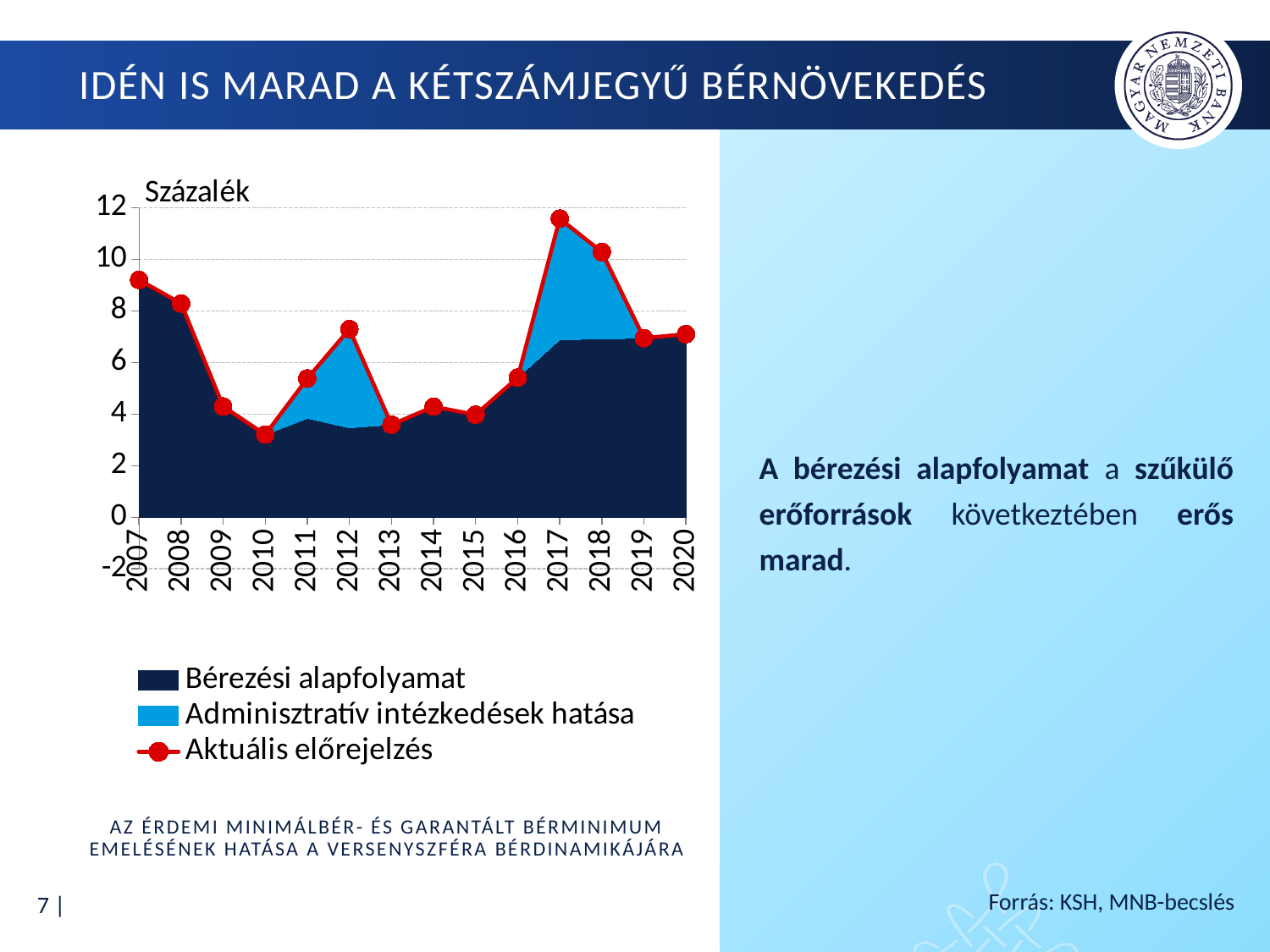
Is the value of the Aktuális előrejelzés line for 2017 greater or less than 10? greater Is the value of the Aktuális előrejelzés line for 2010 greater or less than 4? less How many years are shown on the x axis of the chart? 14 What kind of chart is shown on the slide? Stacked area chart with a line series In which year does the Aktuális előrejelzés line reach its highest value? 2017 How many series does the chart legend list? 3 Is the value of the Aktuális előrejelzés line for 2012 greater or less than 6? greater Which year has the larger value on the Aktuális előrejelzés line, 2011 or 2012? 2012 Which year has the larger value on the Aktuális előrejelzés line, 2017 or 2018? 2017 What unit label is shown at the top of the chart's vertical axis? Százalék Does the Aktuális előrejelzés line rise or fall from 2007 to 2010? fall